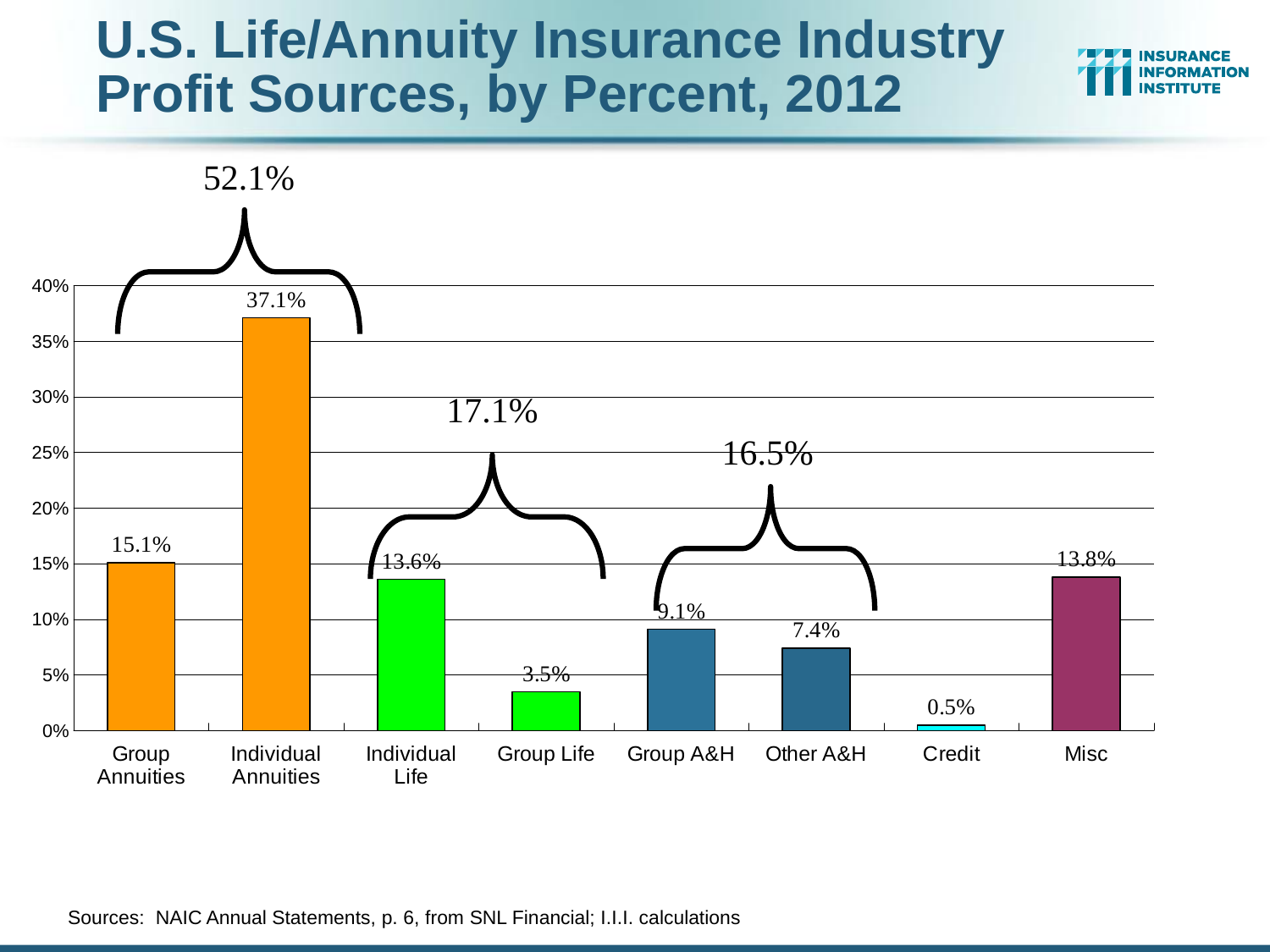
Which is larger, the value for Group Annuities or the value for Misc? Group Annuities How many categories are shown on the x axis? 8 What is the difference between the values for Group Annuities and Individual Life? 1.5% Which category has the highest value? Individual Annuities What combined percentage is shown by the bracket over Group Annuities and Individual Annuities? 52.1% What is the value for Group Life? 3.5% What is the value for Misc? 13.8% Is the value for Individual Annuities greater or less than 35%? greater What is the difference between the values for Group A&H and Other A&H? 1.7% Which category has the lowest value? Credit What kind of chart is this? bar chart What is the value for Individual Annuities? 37.1%